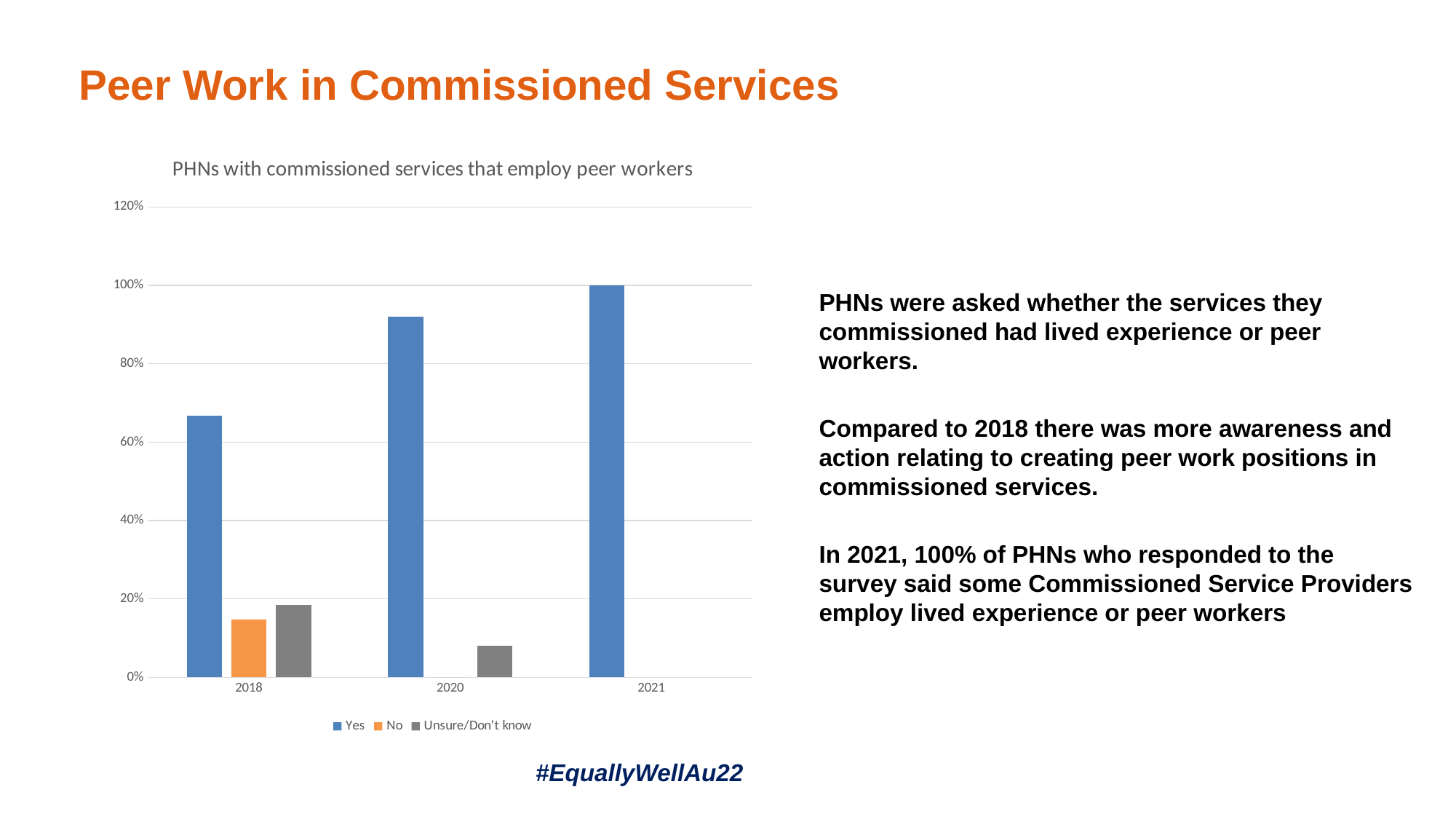
What is the title of the chart? PHNs with commissioned services that employ peer workers What kind of chart is shown on the slide? bar chart Does the Yes series rise or fall from 2018 to 2021? rise Is the value of the Yes series for 2020 greater or less than 80%? greater What is the value of the Yes series for 2021? 100% How many years are shown on the x axis of the chart? 3 Is the value of the Unsure/Don't know series for 2020 greater or less than 20%? less Which year has the lowest value for the Yes series? 2018 Is the value of the Yes series for 2018 greater or less than 60%? greater Which is larger in 2018, the Yes value or the No value? Yes How many series does the chart legend list? 3 Which year has the highest value for the Yes series? 2021